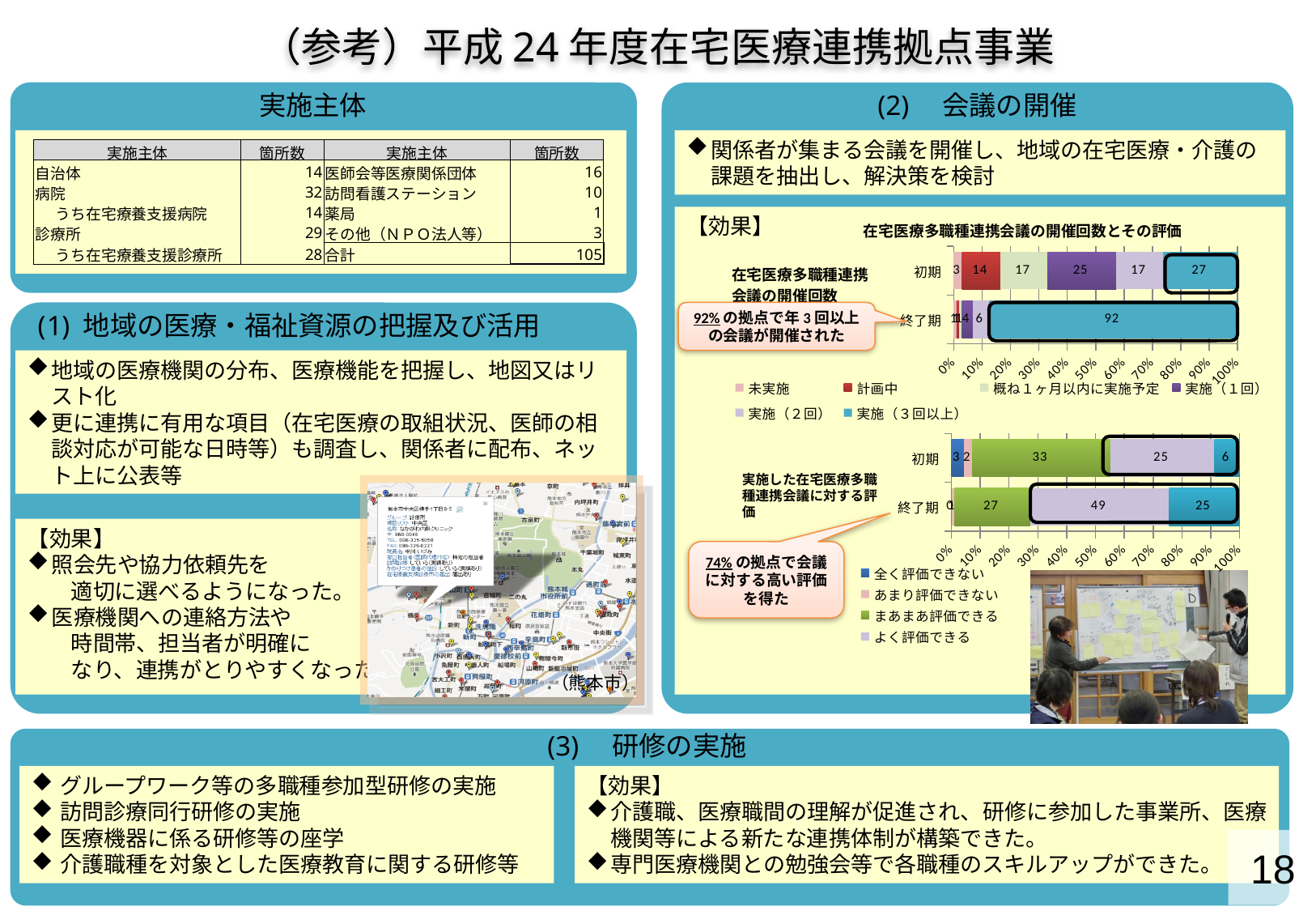
In the top chart (在宅医療多職種連携会議の開催回数), how many series does the legend list? 6 In the top chart (在宅医療多職種連携会議の開催回数), what is the value for 実施（3回以上） in the 初期 bar? 27 In the bottom chart (実施した在宅医療多職種連携会議に対する評価), how many categories (bars) are shown? 2 In the top chart (在宅医療多職種連携会議の開催回数), what is the difference between the 実施（3回以上） values for 終了期 and 初期? 65 In the top chart (在宅医療多職種連携会議の開催回数), which series has the largest segment in the 終了期 bar? 実施（3回以上） In the bottom chart (実施した在宅医療多職種連携会議に対する評価), what is the value for よく評価できる in the 終了期 bar? 49 What kind of chart is the top chart (在宅医療多職種連携会議の開催回数)? Stacked bar chart In the chart titled 在宅医療多職種連携会議の開催回数とその評価 (top chart), what is the value for 実施（3回以上） in the 終了期 bar? 92 In the top chart (在宅医療多職種連携会議の開催回数), what is the value for 実施（1回） in the 初期 bar? 25 In the top chart (在宅医療多職種連携会議の開催回数), what is the value for 計画中 in the 初期 bar? 14 In the bottom chart (実施した在宅医療多職種連携会議に対する評価), what is the difference between the よく評価できる values for 終了期 and 初期? 24 In the bottom chart (実施した在宅医療多職種連携会議に対する評価), what is the value for まあまあ評価できる in the 初期 bar? 33